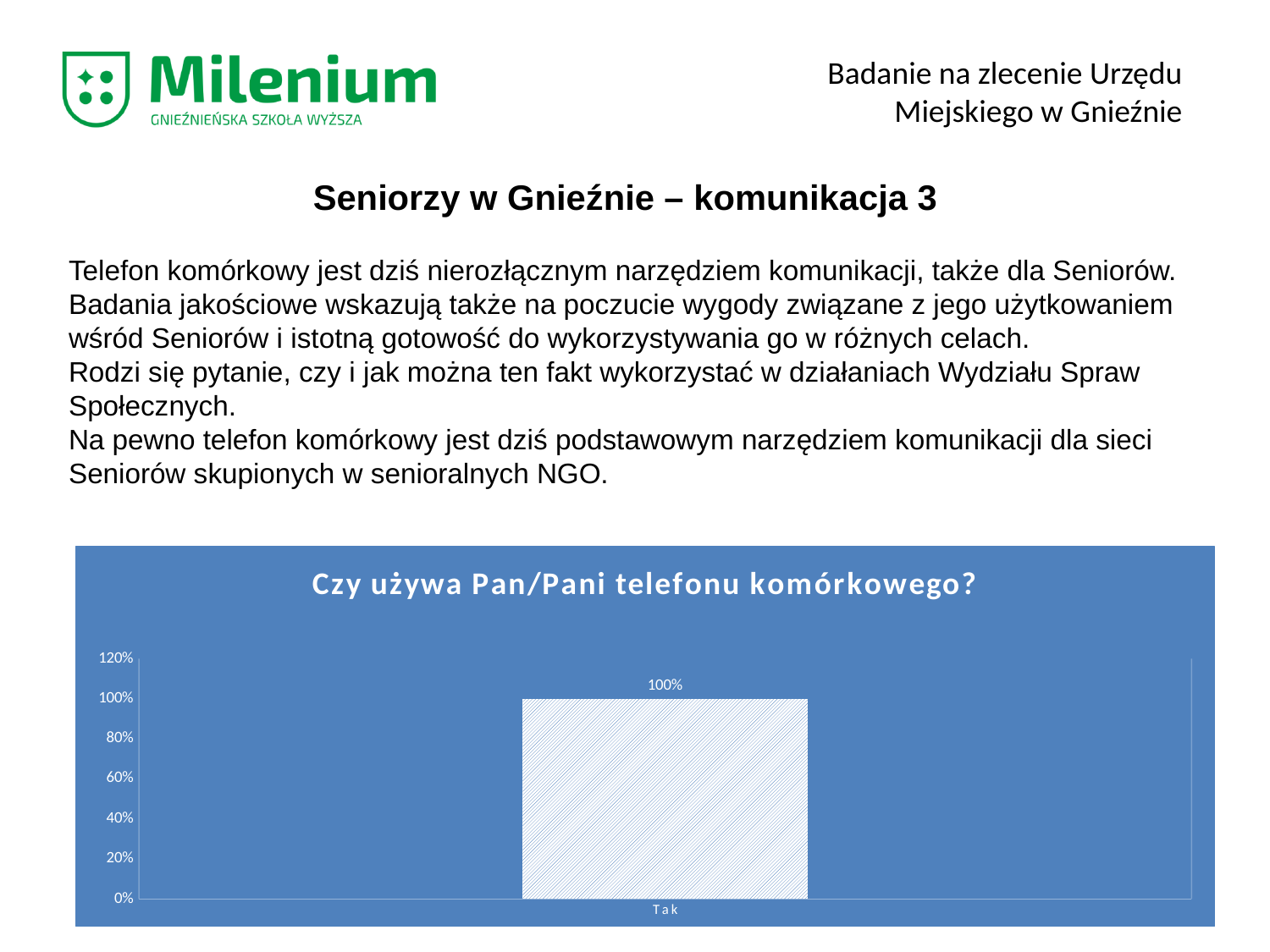
What is the highest value shown on the y axis of the chart? 120% What is the title of the chart? Czy używa Pan/Pani telefonu komórkowego? What is the label of the only category on the x axis of the chart? Tak What is the value for "Tak" in the chart? 100% Is the value for "Tak" greater or less than 80%? greater How many categories are plotted in the chart? 1 What kind of chart is shown on the slide? bar chart